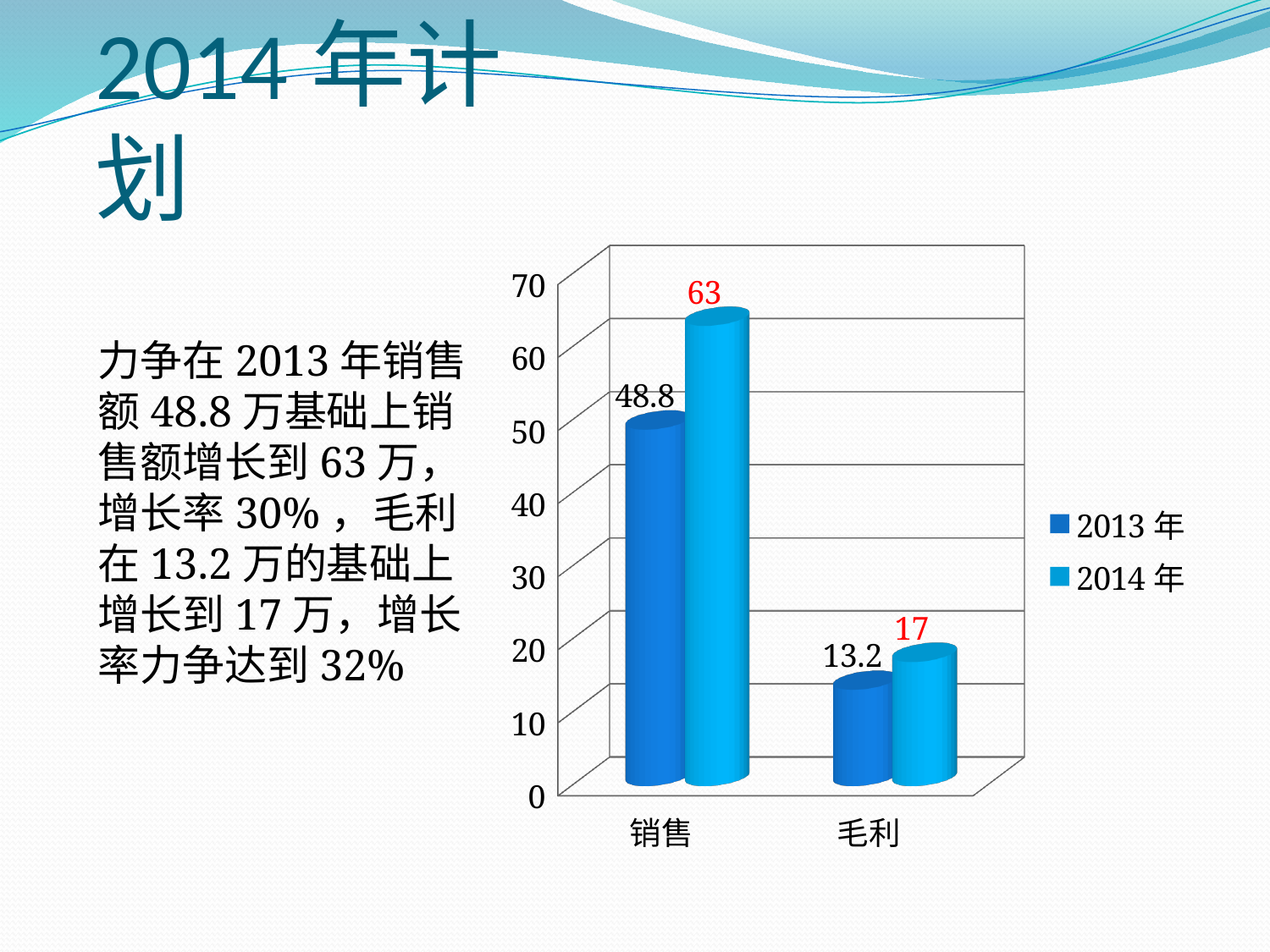
What is the value for 销售 in the 2014 年 series? 63 What is the value for 毛利 in the 2014 年 series? 17 What is the value for 销售 in the 2013 年 series? 48.8 What is the difference between the 2014 年 and 2013 年 values for 毛利? 3.8 What is the difference between the 2014 年 and 2013 年 values for 销售? 14.2 How many series does the legend list? 2 Which category has the highest value in the 2014 年 series? 销售 Which category has the lowest value in the 2013 年 series? 毛利 What is the value for 毛利 in the 2013 年 series? 13.2 How many categories are shown on the x axis? 2 What kind of chart is shown on the slide? Bar chart Which is larger: the 2013 年 value for 销售 or the 2014 年 value for 毛利? 2013 年 value for 销售